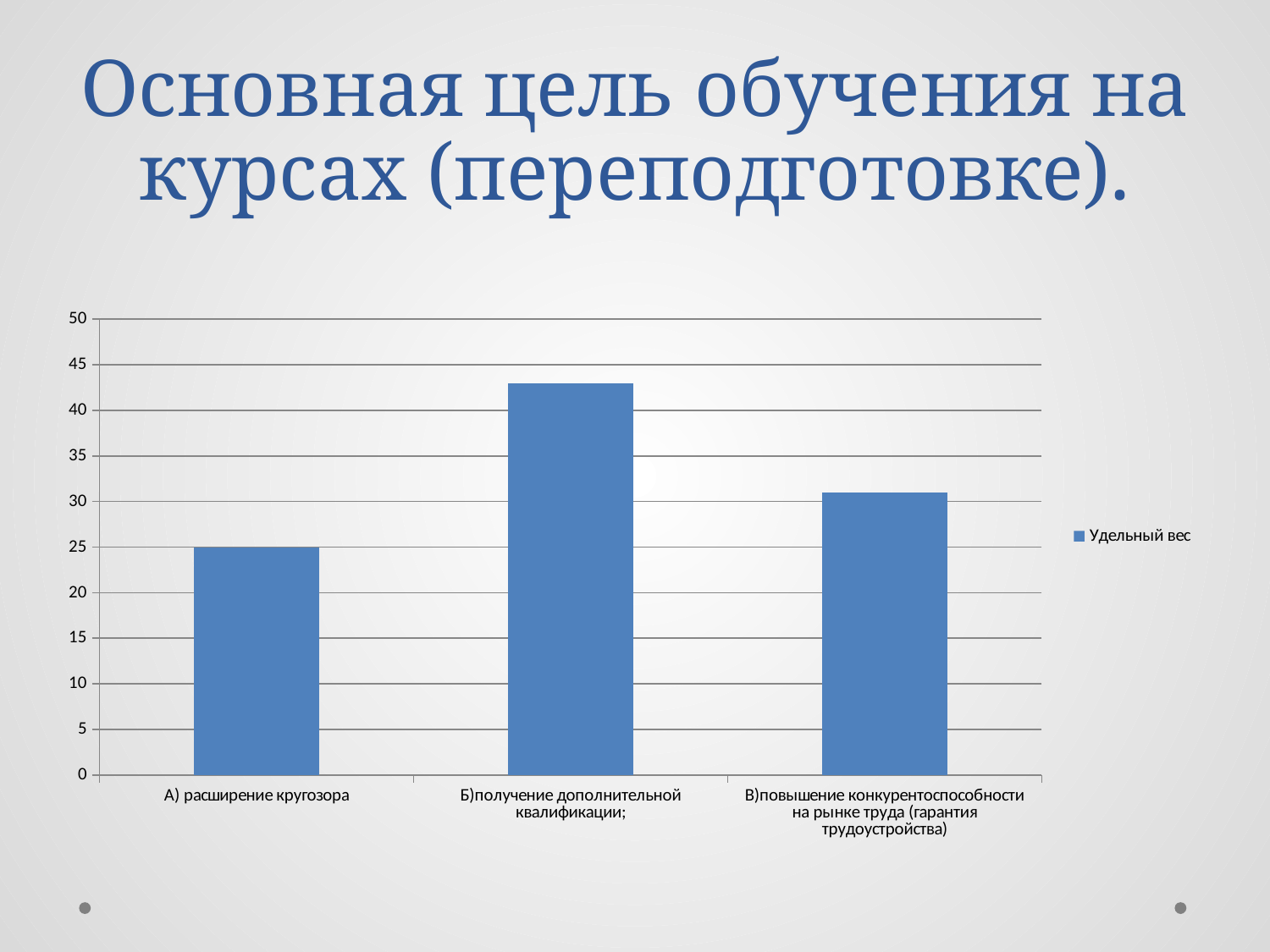
Is the value for "А) расширение кругозора" greater or less than 30? less How many categories are plotted in the chart? 3 Is the value for "В)повышение конкурентоспособности на рынке труда (гарантия трудоустройства)" greater or less than 35? less What kind of chart is shown on the slide? Bar chart Is the value for "Б)получение дополнительной квалификации;" greater or less than 40? greater What is the value for "А) расширение кругозора"? 25 What is the title of the slide containing the chart? Основная цель обучения на курсах (переподготовке). Which category has the highest value? Б)получение дополнительной квалификации; Which category has the lowest value? А) расширение кругозора How many series does the legend list? 1 Which is larger: the value for "Б)получение дополнительной квалификации;" or for "В)повышение конкурентоспособности на рынке труда (гарантия трудоустройства)"? Б)получение дополнительной квалификации; What is the name of the series shown in the legend? Удельный вес